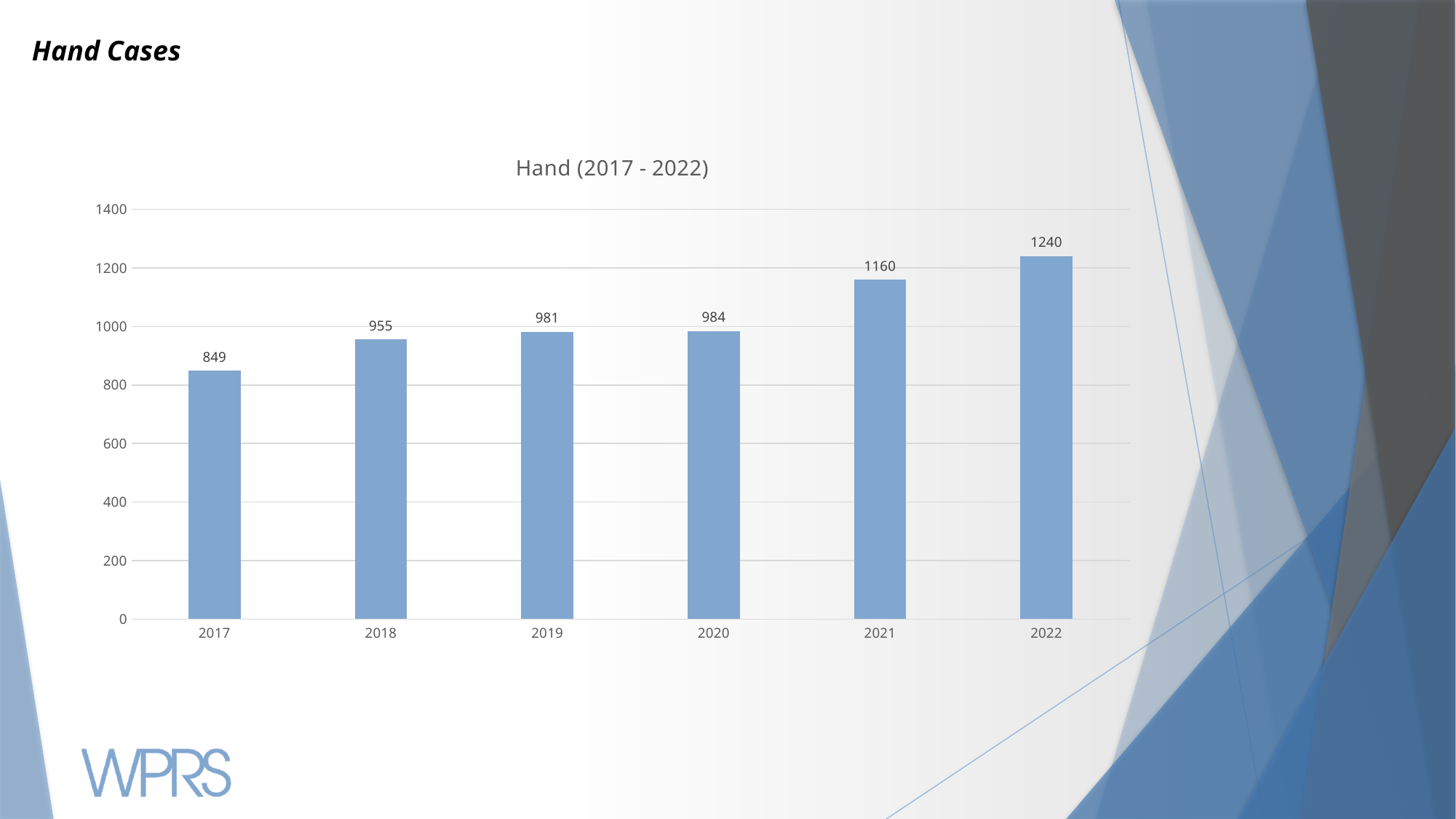
What is the difference between the values for 2022 and 2021? 80 How many years are shown on the x axis? 6 What is the value for 2022? 1240 What is the difference between the values for 2018 and 2017? 106 What is the value for 2020? 984 Which is larger, the value for 2019 or the value for 2021? 2021 Do the values rise or fall from 2017 to 2022? rise What is the value for 2017? 849 Which year has the highest value? 2022 Which year has the lowest value? 2017 What kind of chart is shown? bar chart Is the value for 2021 greater or less than 1000? greater